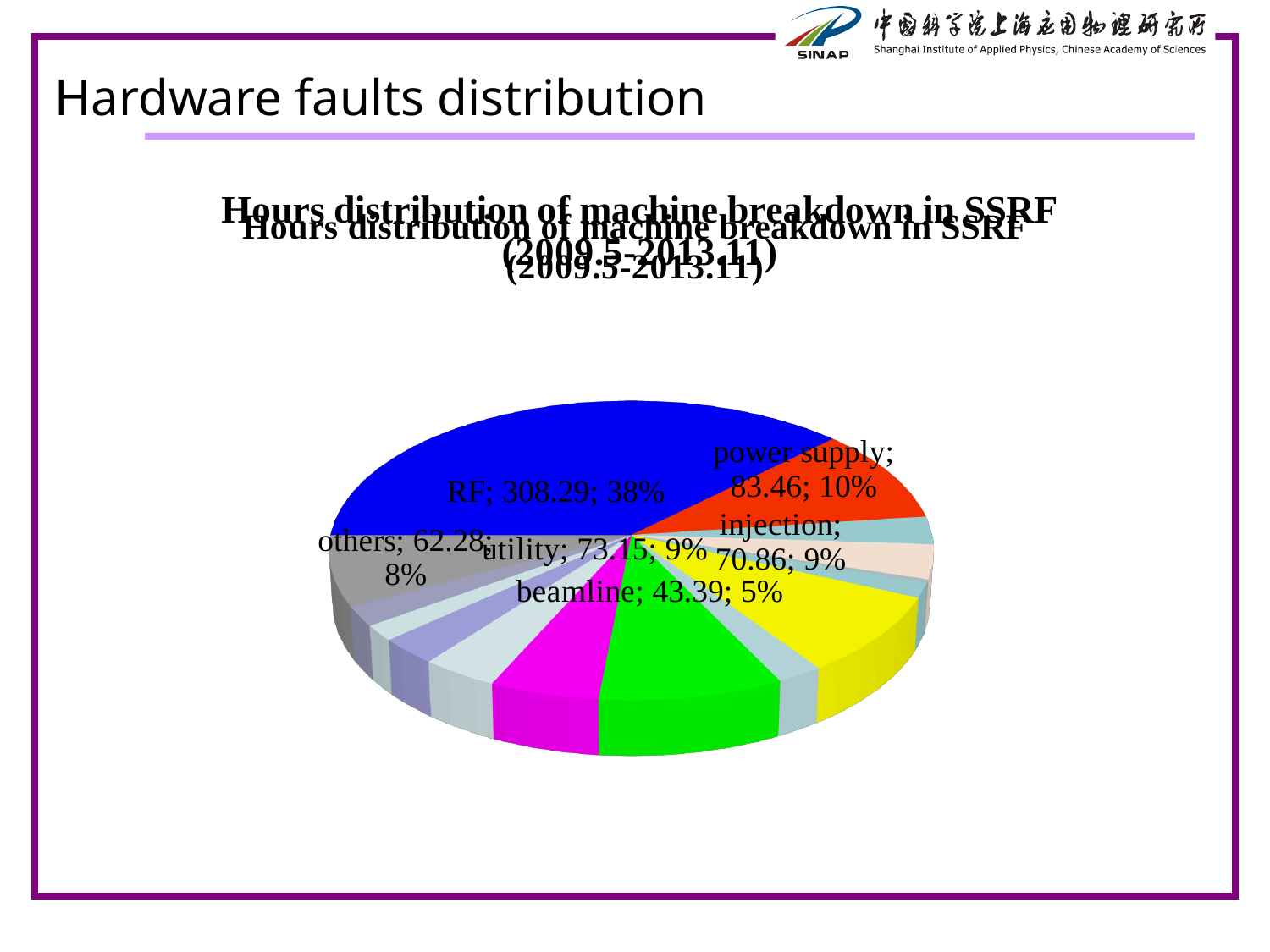
How many hours are attributed to utility? 73.15 What share of the pie does RF account for? 38% What is the difference in hours between RF and power supply? 224.83 Which has more hours, power supply or beamline? power supply How many hours are attributed to power supply? 83.46 Which labelled category has the largest number of hours? RF What kind of chart is shown on the slide? pie chart How many hours are attributed to beamline? 43.39 What share of the pie does others account for? 8% How many hours are attributed to injection? 70.86 What is the title of the chart? Hours distribution of machine breakdown in SSRF (2009.5-2013.11) How many hours are attributed to RF? 308.29